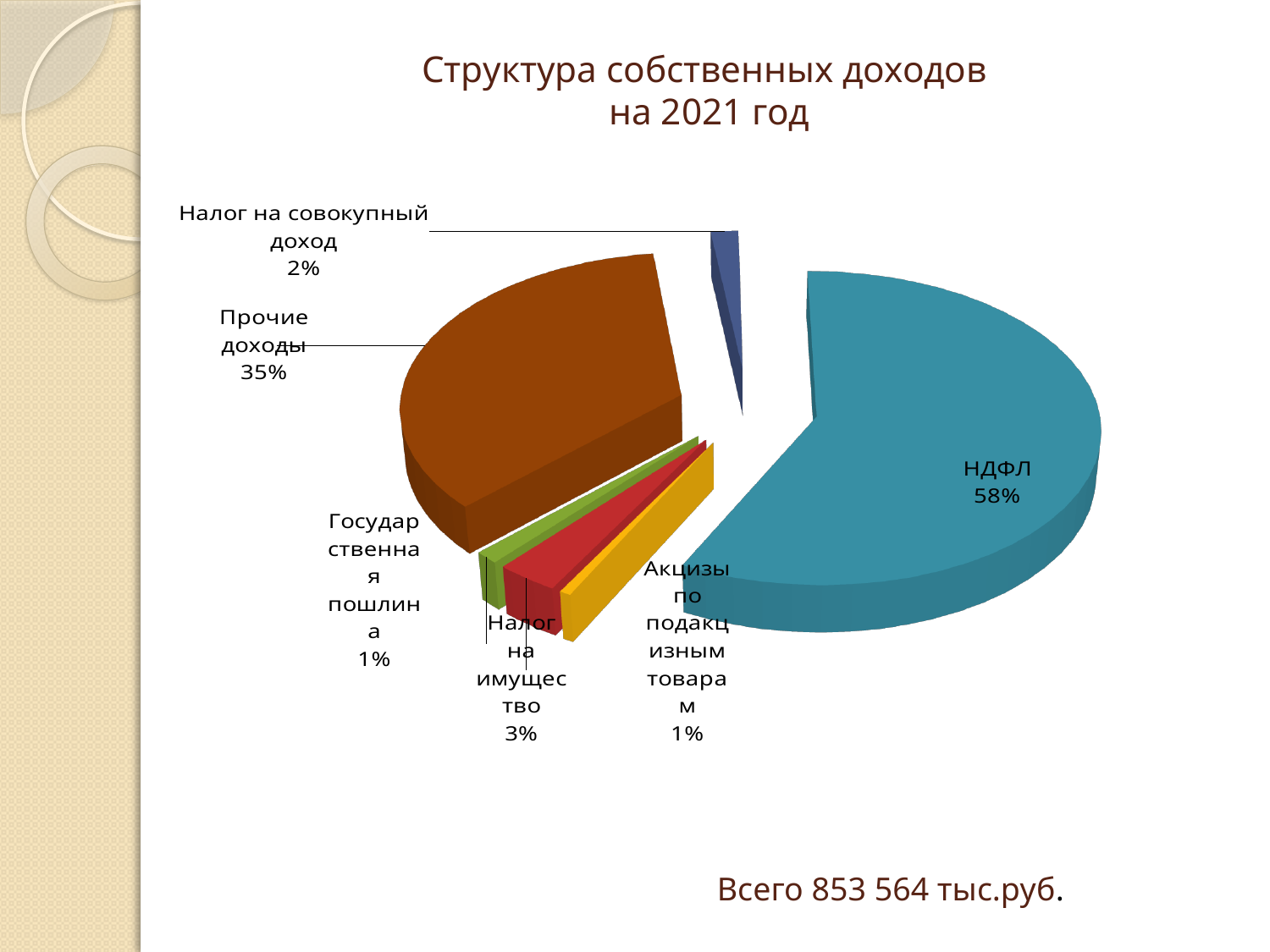
What percentage is shown for Налог на совокупный доход? 2% What share of own revenues does НДФЛ account for? 58% What is the title of the chart? Структура собственных доходов на 2021 год Which category has the largest share of own revenues? НДФЛ What share of own revenues is Прочие доходы? 35% What total amount of own revenues is stated on the slide? 853 564 тыс.руб. What percentage is shown for Государственная пошлина? 1% What is the difference in percentage points between НДФЛ and Прочие доходы? 23 Which is larger, the share of Налог на имущество or the share of Налог на совокупный доход? Налог на имущество What kind of chart is shown on the slide? Pie chart How many slices does the pie chart have? 6 What percentage is shown for Налог на имущество? 3%